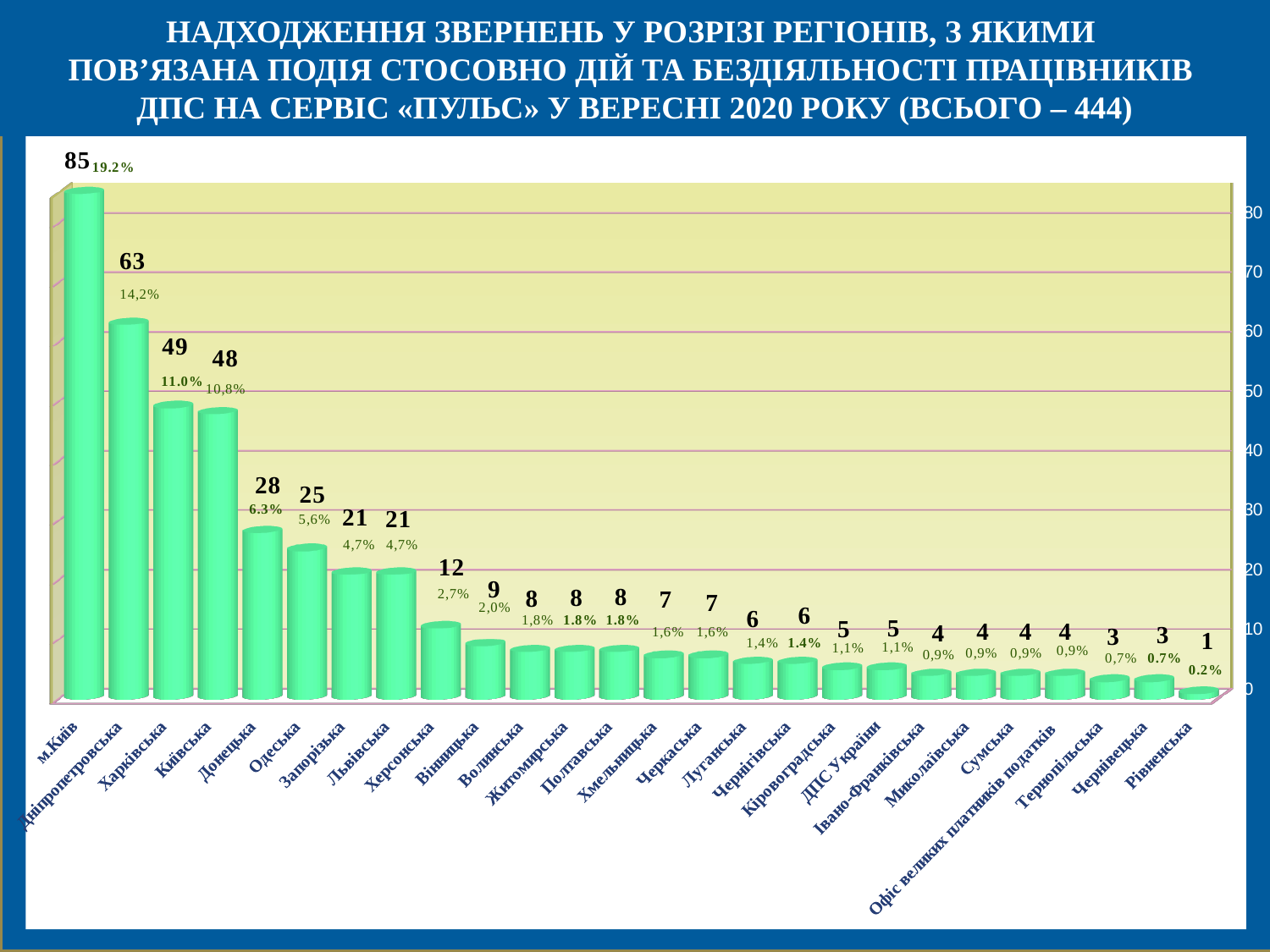
How many appeals are shown for м.Київ? 85 What is the difference between the number of appeals for м.Київ and Дніпропетровська? 22 How many appeals are shown for Херсонська? 12 What percentage share is shown for Дніпропетровська? 14,2% How many regions (categories) are shown on the chart? 26 Which region has the highest number of appeals? м.Київ What type of chart is shown on the slide? bar chart Do the values generally rise or fall from left to right along the x axis? fall Which has more appeals, Донецька or Одеська? Донецька What percentage share is shown for Рівненська? 0.2% What is the total number of appeals stated in the slide title? 444 Which region has the lowest number of appeals? Рівненська